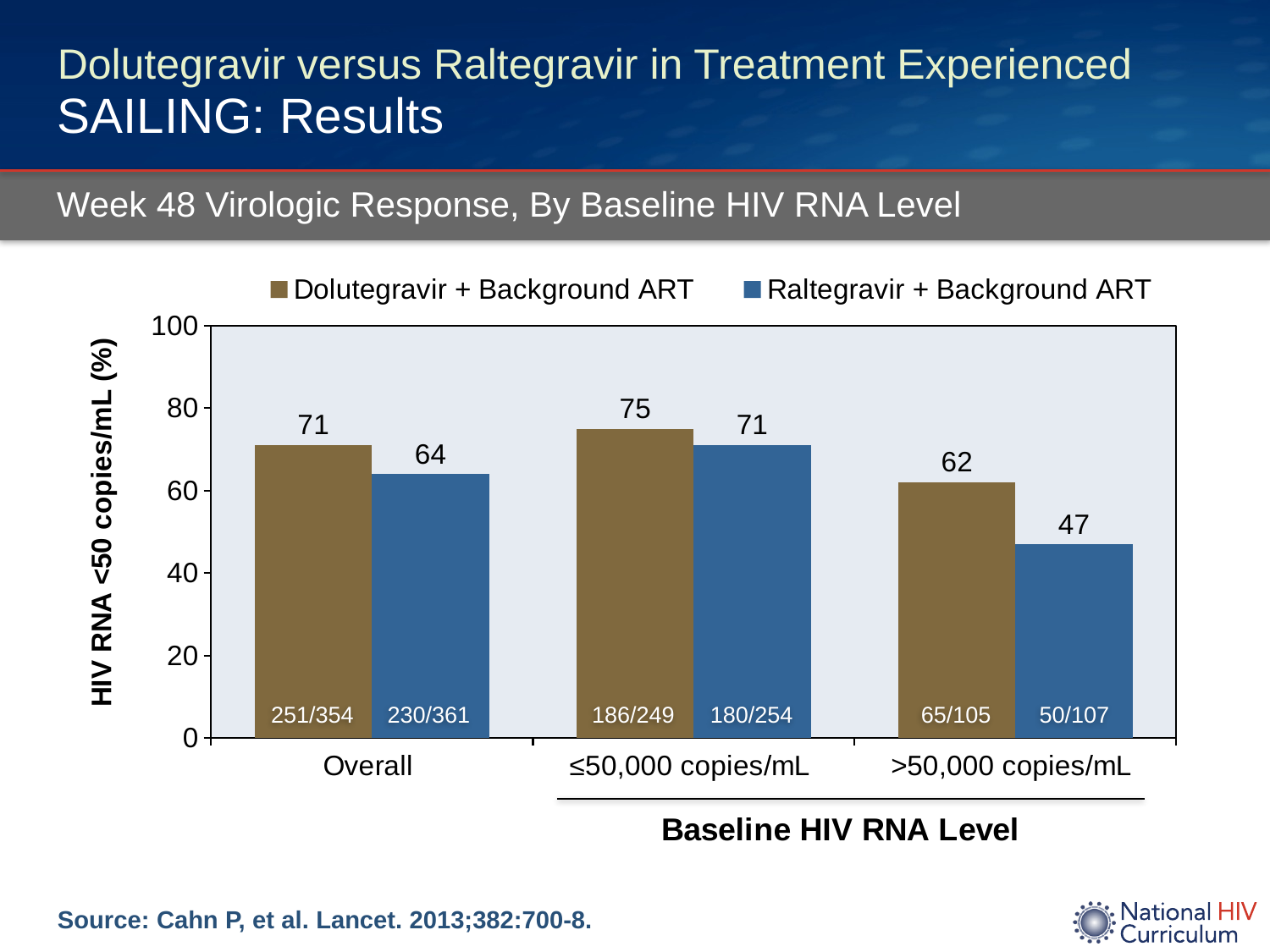
Which category has the highest value for Dolutegravir + Background ART? ≤50,000 copies/mL What is the value for Raltegravir + Background ART in the >50,000 copies/mL category? 47 What is the difference between the Dolutegravir + Background ART and Raltegravir + Background ART values in the >50,000 copies/mL category? 15 Is the value for Raltegravir + Background ART in the >50,000 copies/mL category greater or less than 60? less In the Overall category, which series has the larger value, Dolutegravir + Background ART or Raltegravir + Background ART? Dolutegravir + Background ART Which category has the lowest value for Raltegravir + Background ART? >50,000 copies/mL What is the label of the y axis? HIV RNA <50 copies/mL (%) How many series does the legend list? 2 What is the value for Dolutegravir + Background ART in the Overall category? 71 What is the value for Raltegravir + Background ART in the ≤50,000 copies/mL category? 71 How many categories are shown on the x axis? 3 What kind of chart is shown on the slide? bar chart